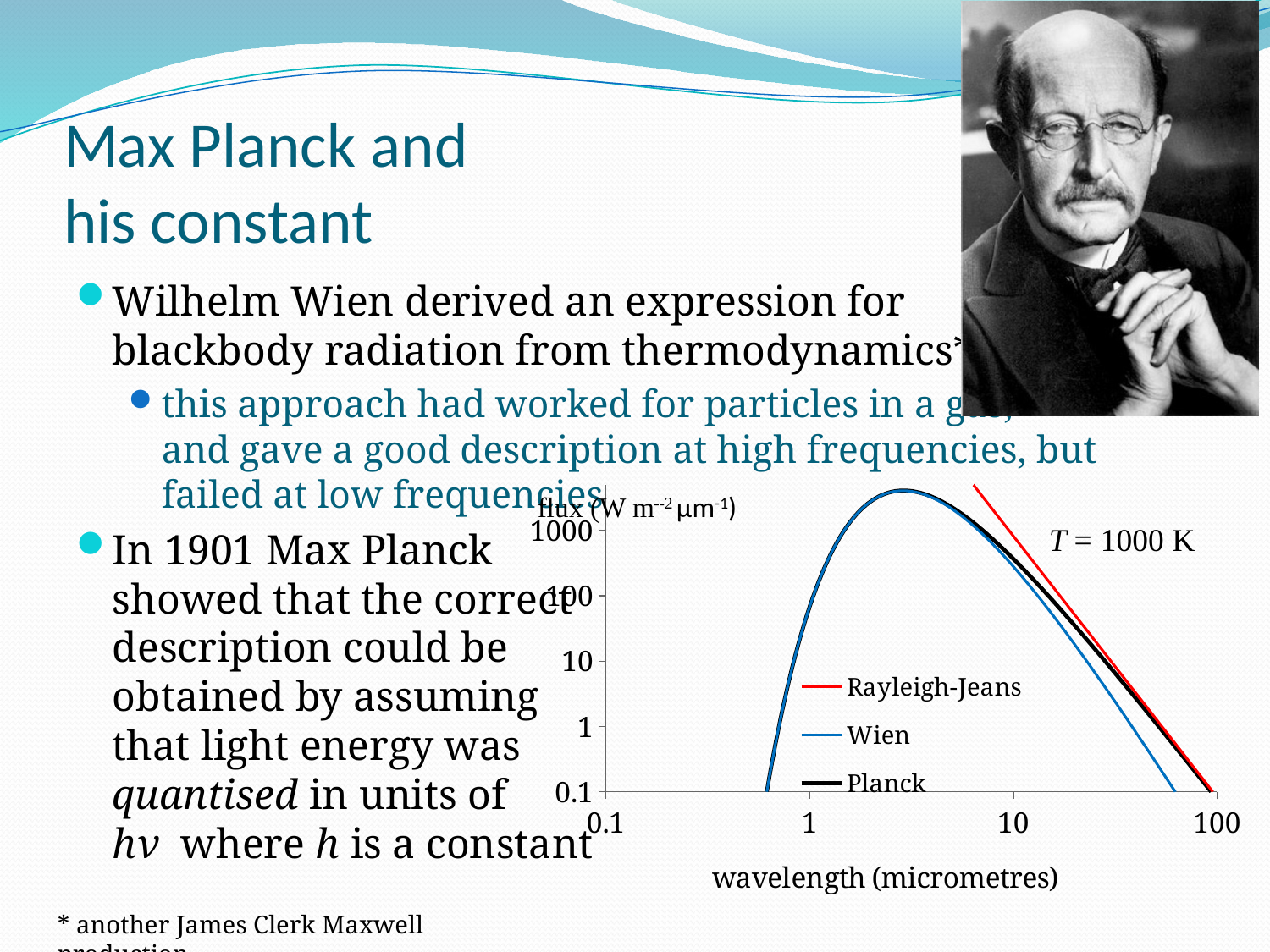
What kind of chart is shown on the slide? line chart Is the wavelength at which the curves peak greater or less than 1 micrometre? greater How many series does the chart's legend list? 3 Which colour is used for the Planck curve in the chart? black Beyond the peak, do the curves rise or fall as wavelength increases? fall What is the label of the x axis of the chart? wavelength (micrometres) At a wavelength of 100 micrometres, which curve is higher, Rayleigh-Jeans or Wien? Rayleigh-Jeans Is the wavelength at which the curves peak greater or less than 10 micrometres? less How many labelled tick values are shown on the x axis? 4 Is the peak flux of the Planck curve greater or less than 100? greater What are the three series named in the chart's legend? Rayleigh-Jeans, Wien, Planck What temperature is annotated on the chart? T = 1000 K